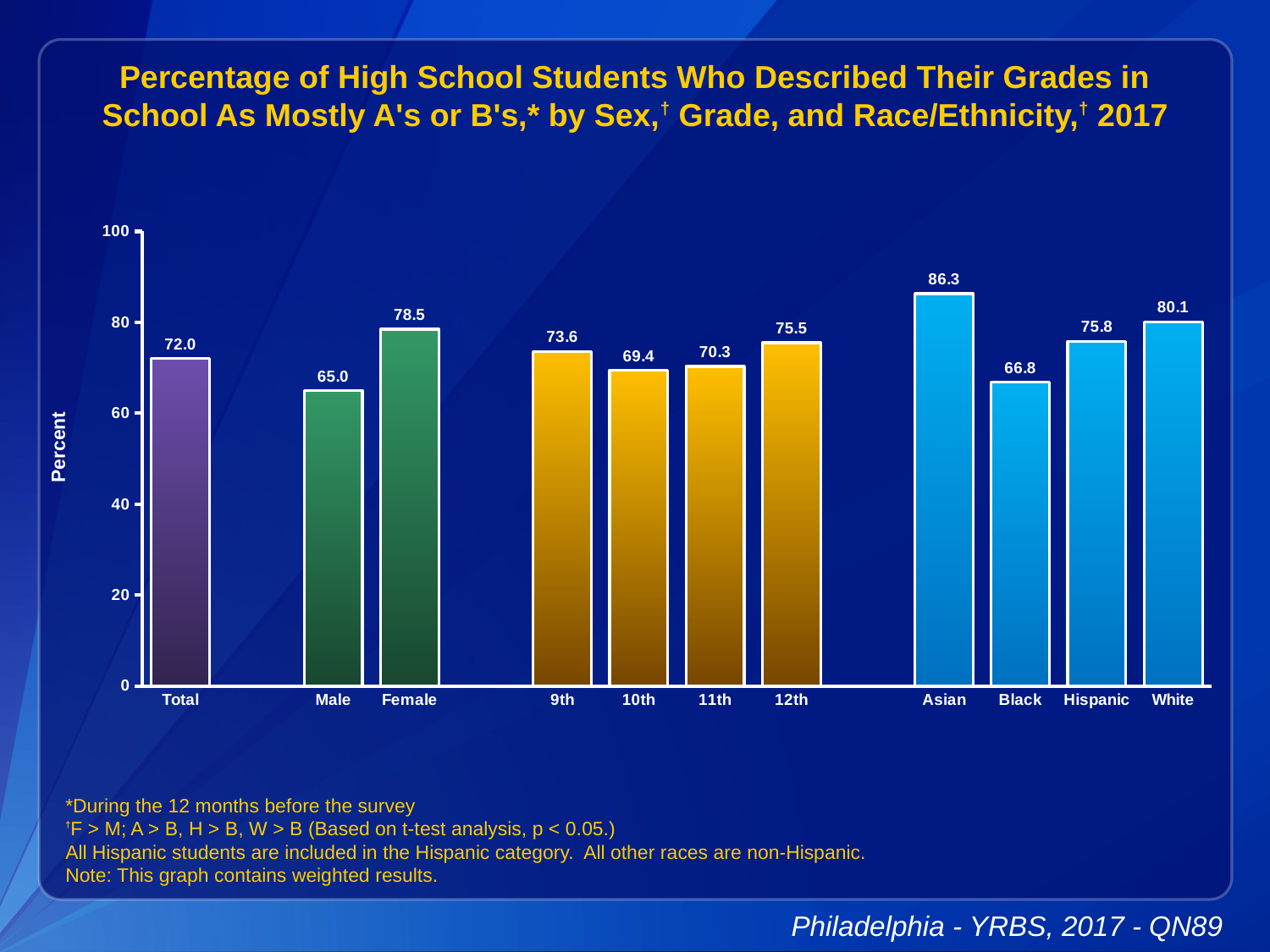
Which is larger, the value for 12th grade or the value for 9th grade? 12th How many categories are shown on the x axis? 11 What is the value for 10th grade students? 69.4 Is the value for White greater or less than 60? greater Which category has the lowest value? Male What is the difference between the Female and Male values? 13.5 What percentage of Female students described their grades as mostly A's or B's? 78.5 What is the label on the y axis? Percent What is the value for Total? 72.0 What is the difference between the Asian and Black values? 19.5 What kind of chart is shown on the slide? Bar chart Which category has the highest value? Asian